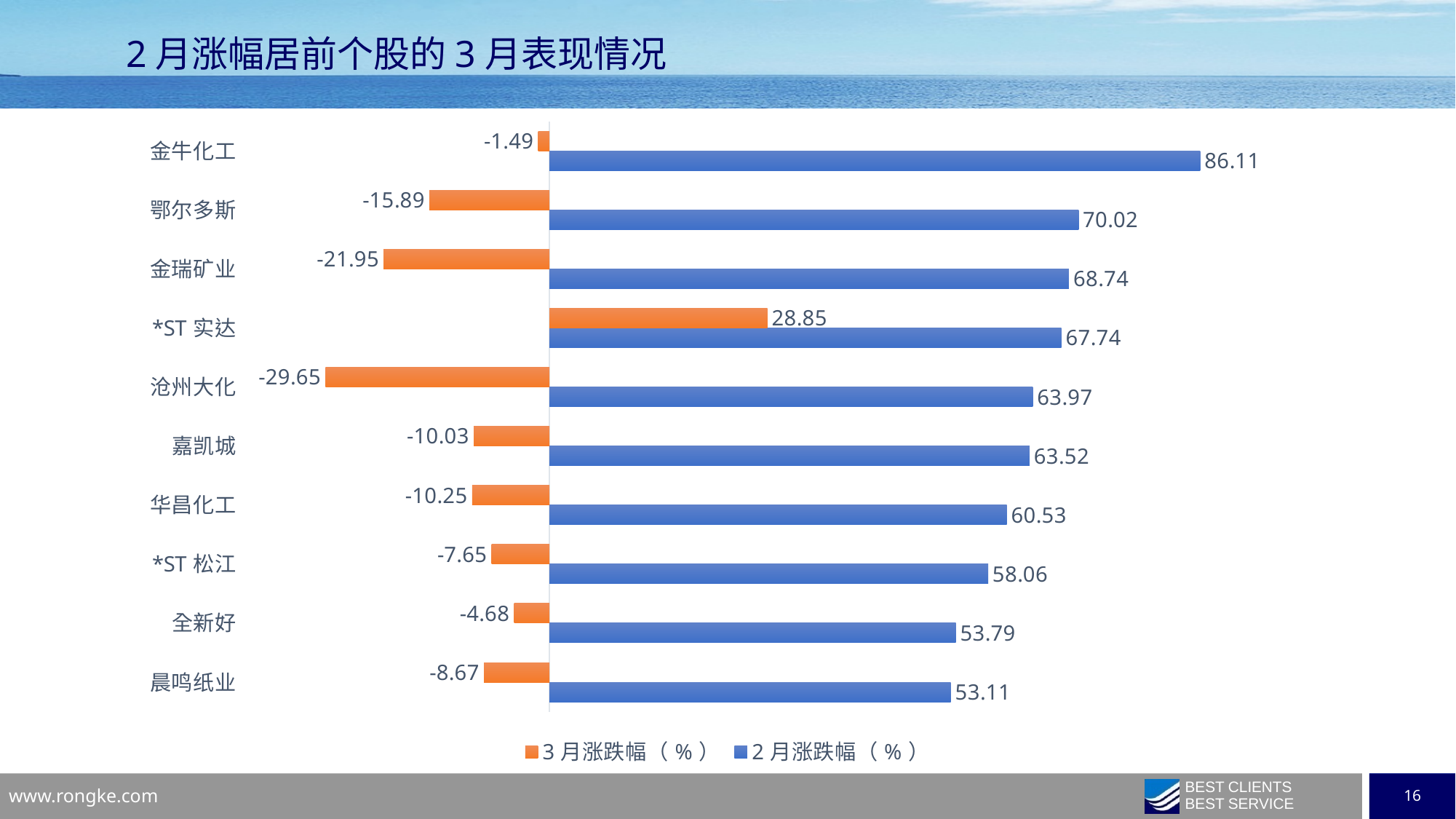
What is the 2月涨跌幅（%） value for 金牛化工? 86.11 Which stock has the highest 2月涨跌幅（%） value? 金牛化工 What is the 3月涨跌幅（%） value for 沧州大化? -29.65 Which stock has the lowest 3月涨跌幅（%） value? 沧州大化 What is the difference between the 2月涨跌幅（%） values of 金牛化工 and 鄂尔多斯? 16.09 How many series does the legend list? 2 Which stock has the lowest 2月涨跌幅（%） value? 晨鸣纸业 What is the 3月涨跌幅（%） value for *ST 实达? 28.85 Which colour represents the 3月涨跌幅（%） series? Orange How many stocks are shown in the chart? 10 Which has a larger 2月涨跌幅（%） value, 嘉凯城 or 华昌化工? 嘉凯城 What kind of chart is shown on the slide? Bar chart